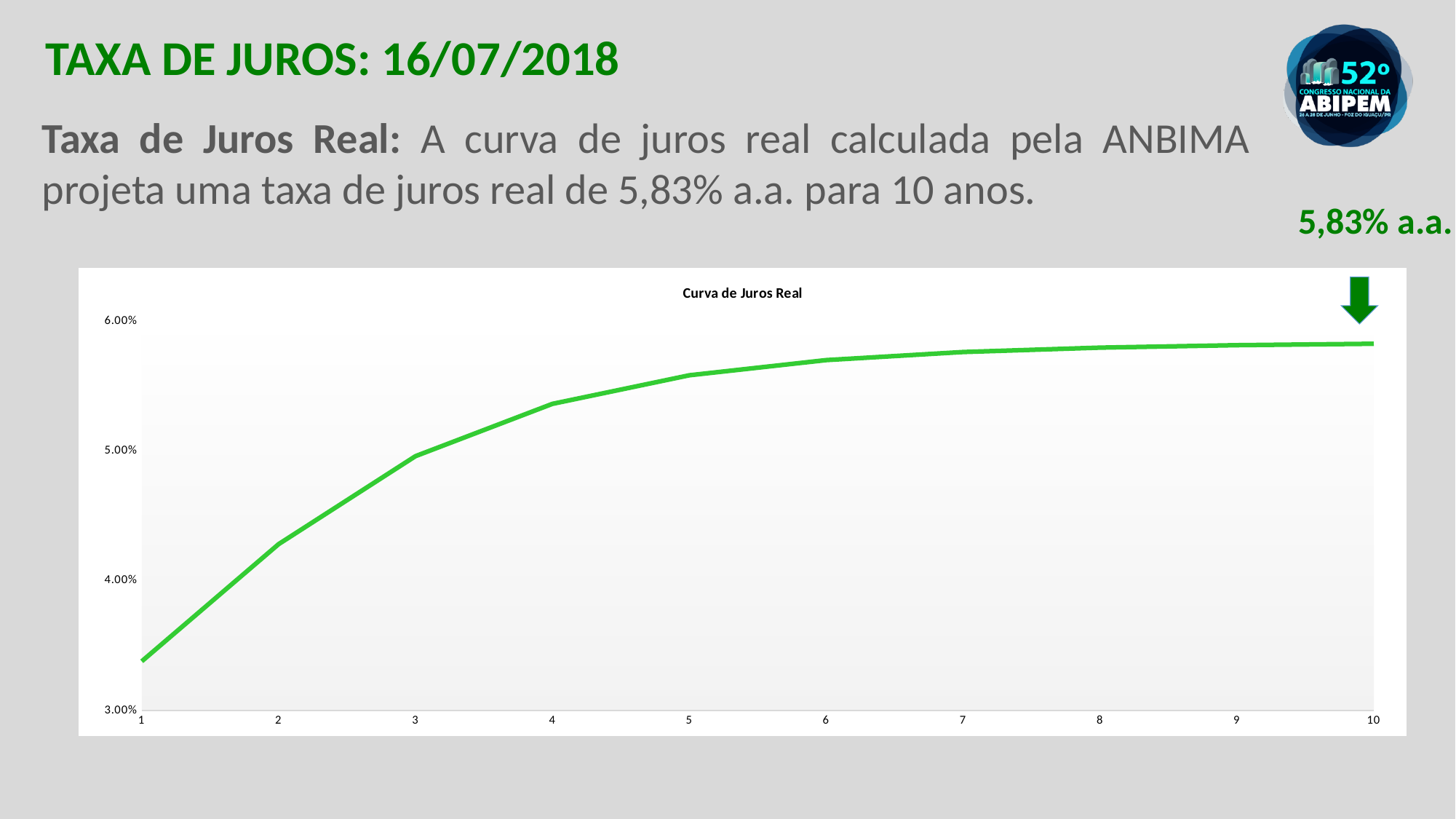
Do the values rise or fall as the x axis goes from 1 to 10? Rise How many points are plotted along the x axis of the chart? 10 What is the title of the chart? Curva de Juros Real What kind of chart is shown on the slide? Line chart At which x-axis point is the value highest? 10 Which is larger, the value at point 2 or the value at point 5? Point 5 Is the value at point 2 greater or less than 4.00%? greater At which x-axis point is the value lowest? 1 What colour is the line in the chart? Green What is the real interest rate projected for 10 years, as shown on the slide? 5,83% a.a. Is the value at point 1 greater or less than 4.00%? less Is the value at point 5 greater or less than 5.00%? greater